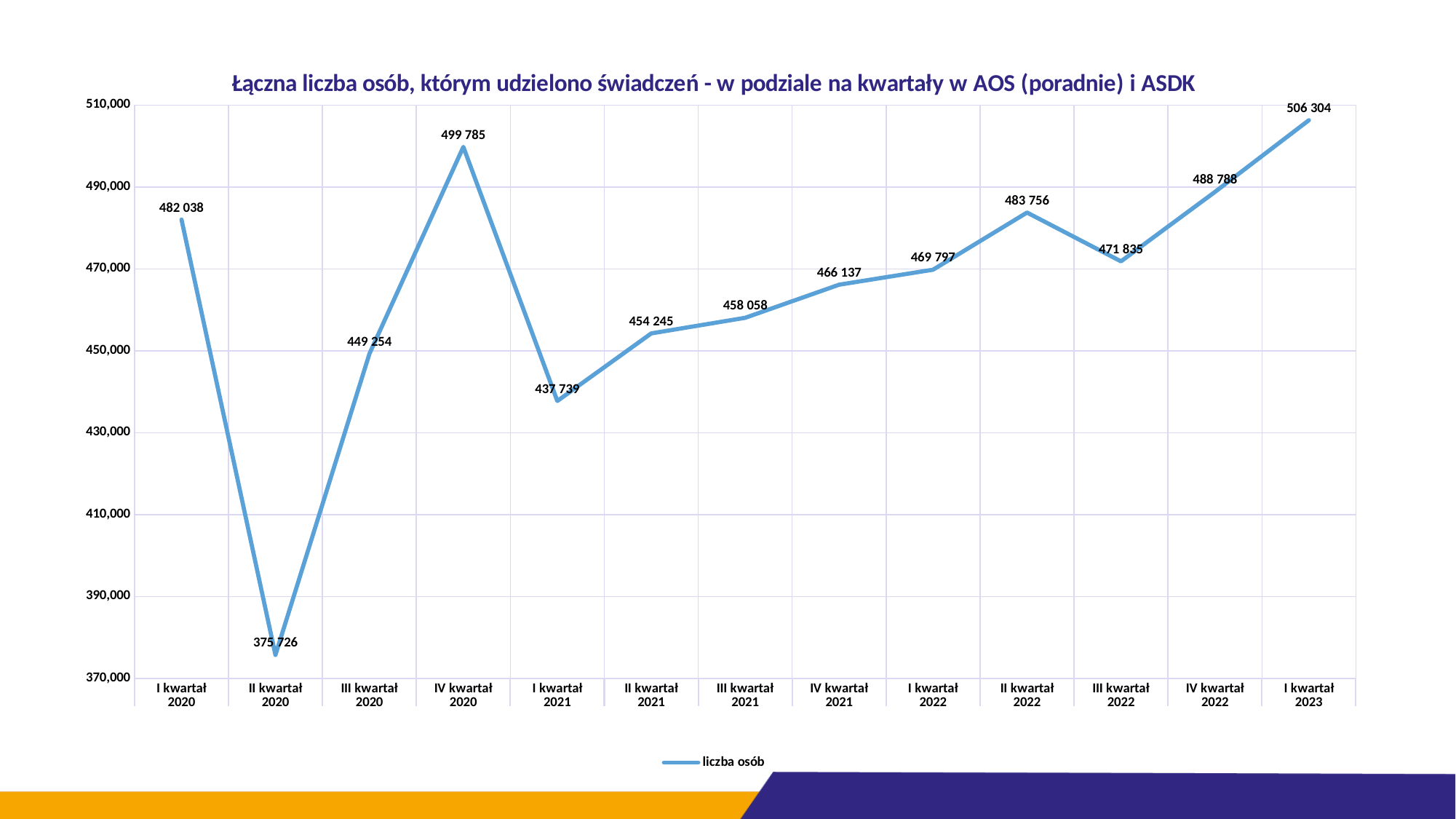
What is the value for I kwartał 2023? 506 304 How many quarters are plotted on the chart? 13 Which quarter has the highest value? I kwartał 2023 What is the value for IV kwartał 2020? 499 785 What is the name of the series shown in the legend? liczba osób What is the value for III kwartał 2022? 471 835 What is the difference between the values for I kwartał 2023 and II kwartał 2020? 130 578 Which quarter has the lowest value? II kwartał 2020 What is the difference between the values for IV kwartał 2020 and I kwartał 2021? 62 046 What kind of chart is shown on the slide? Line chart What is the value for II kwartał 2020? 375 726 Which is larger, the value for II kwartał 2022 or the value for III kwartał 2022? II kwartał 2022